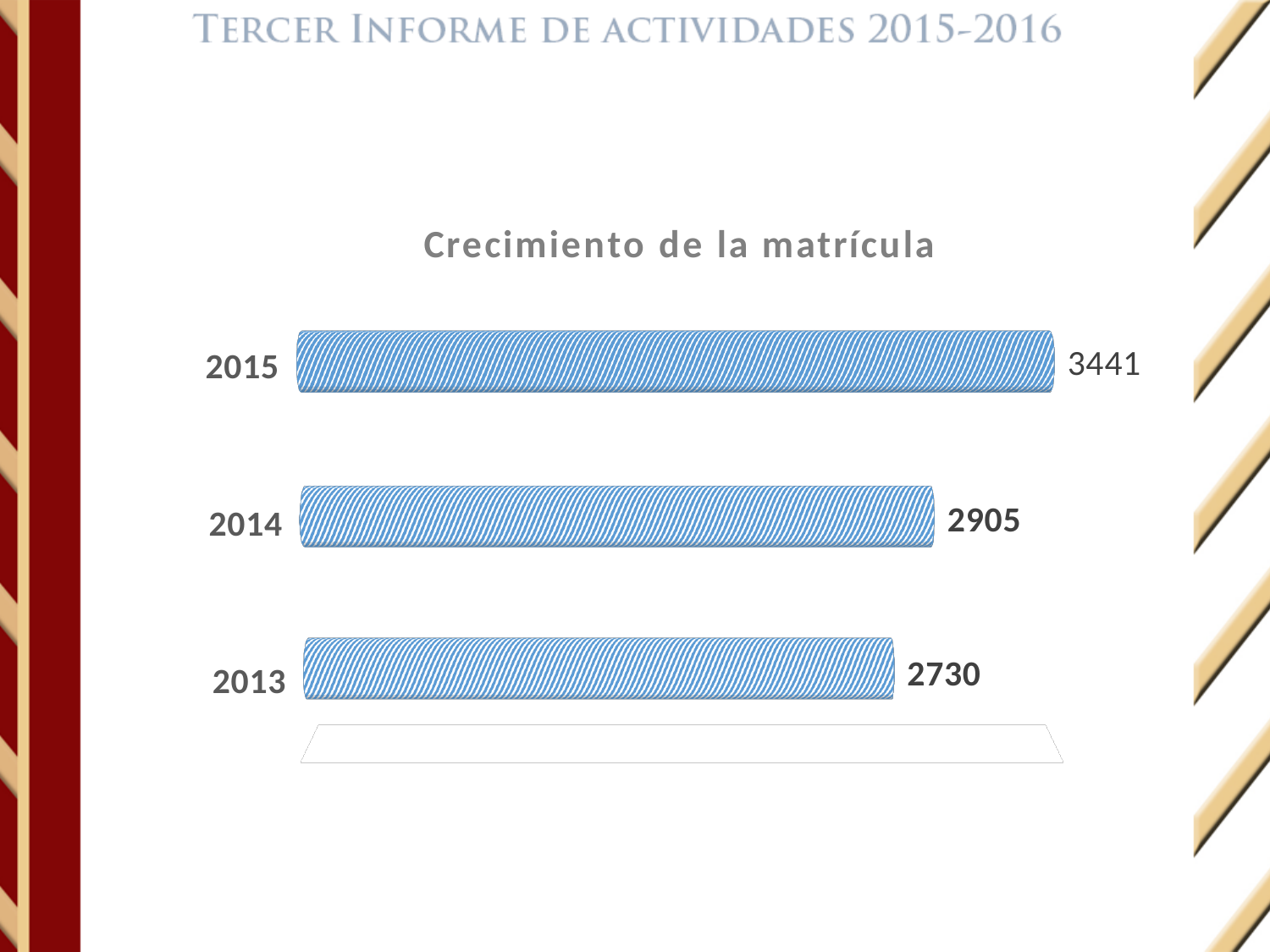
What kind of chart is shown on the slide? bar chart Do the values rise or fall from 2013 to 2015? rise What is the value for 2015? 3441 What is the difference between the values for 2015 and 2014? 536 Which is larger, the value for 2014 or the value for 2013? 2014 What is the value for 2014? 2905 What is the title of the chart? Crecimiento de la matrícula What is the value for 2013? 2730 How many years are shown in the chart? 3 Which year has the highest value? 2015 Which year has the lowest value? 2013 What is the difference between the values for 2014 and 2013? 175